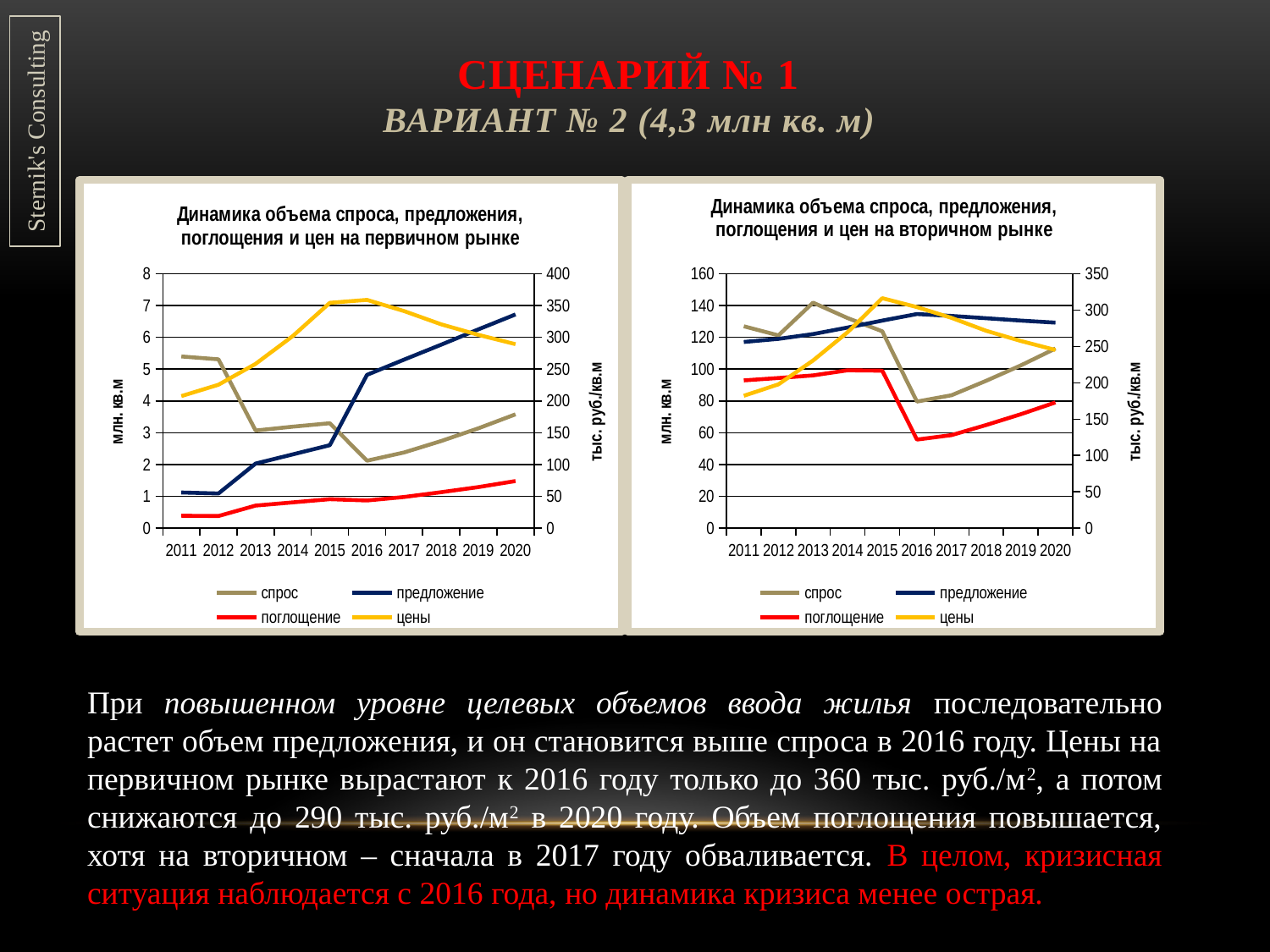
What is the label of the right-hand vertical axis of the left chart (primary market)? тыс. руб./кв.м In the left chart (primary market), does предложение rise or fall from 2011 to 2020? rise In the left chart (primary market), is the value of цены in 2016 greater or less than 300? greater In the right chart (secondary market), is the value of спрос in 2016 greater or less than 100? less In the left chart (primary market), is the value of поглощение in 2020 greater or less than 2? less In the right chart (secondary market), in which year is цены at its highest? 2015 How many series does the legend of the right chart (secondary market) list? 4 In the left chart (primary market), which is larger in 2020: спрос or предложение? предложение What kind of chart is the left chart (first market)? line chart How many years are shown on the x axis of the left chart (primary market)? 10